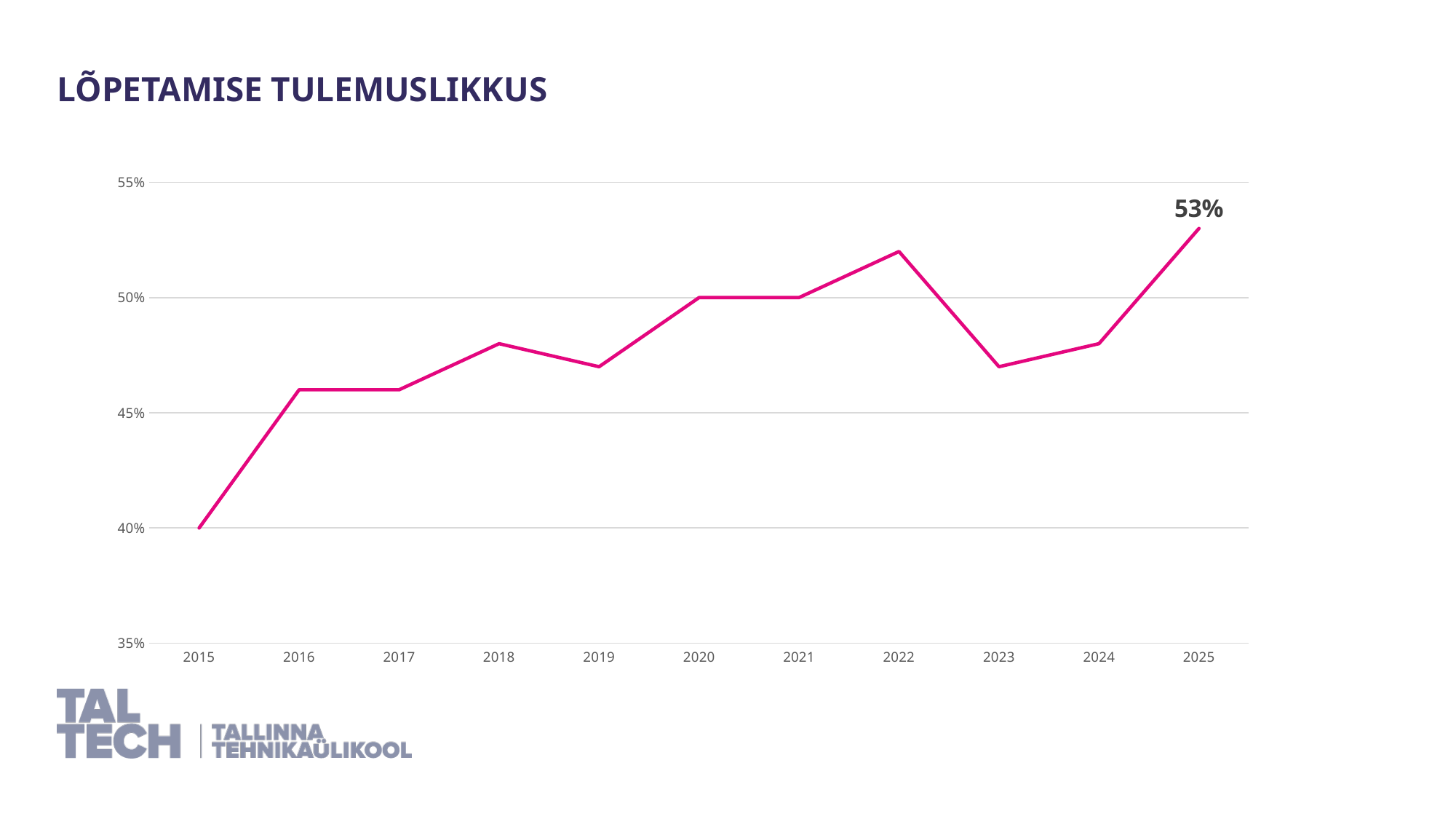
What is the title of the slide? LÕPETAMISE TULEMUSLIKKUS What is the value for 2015? 40% Is the value for 2023 greater or less than 50%? less Which year has the highest value? 2025 Is the value for 2022 greater or less than 50%? greater Which year has the lowest value? 2015 Which is larger, the value for 2018 or the value for 2016? 2018 What is the difference between the value for 2025 and the value for 2015? 13% How many years are shown on the x axis? 11 What is the value for 2025? 53% What kind of chart is shown on the slide? line chart What is the value for 2020? 50%